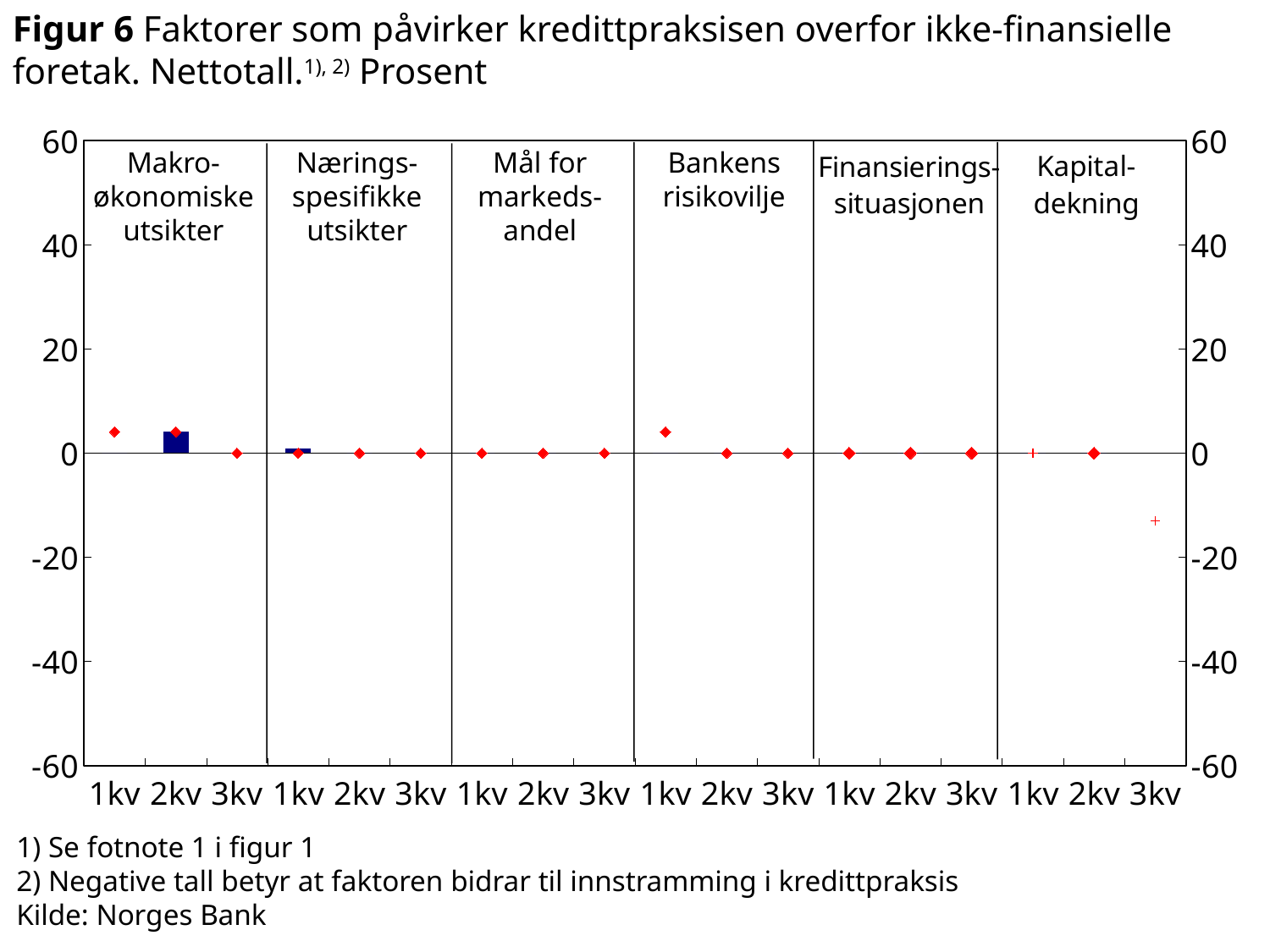
What kind of chart is shown in Figur 6? combination bar and line chart (bars with diamond markers) What is the range of the y axis in the chart? -60 to 60 Do the values for Kapitaldekning rise or fall from 1kv to 3kv? fall Is the value for Makroøkonomiske utsikter in 1kv greater or less than 0? greater What is the value for Mål for markedsandel in 2kv? 0 Is the value for Kapitaldekning in 3kv greater or less than 0? less Which is larger: the value for Makroøkonomiske utsikter in 1kv or the value for Kapitaldekning in 3kv? Makroøkonomiske utsikter in 1kv Which factor and quarter has the lowest value in the chart? Kapitaldekning, 3kv Is the value for Kapitaldekning in 3kv greater or less than -20? greater How many quarters are shown for each factor on the x axis? 3 How many factors (panels) are shown in the chart? 6